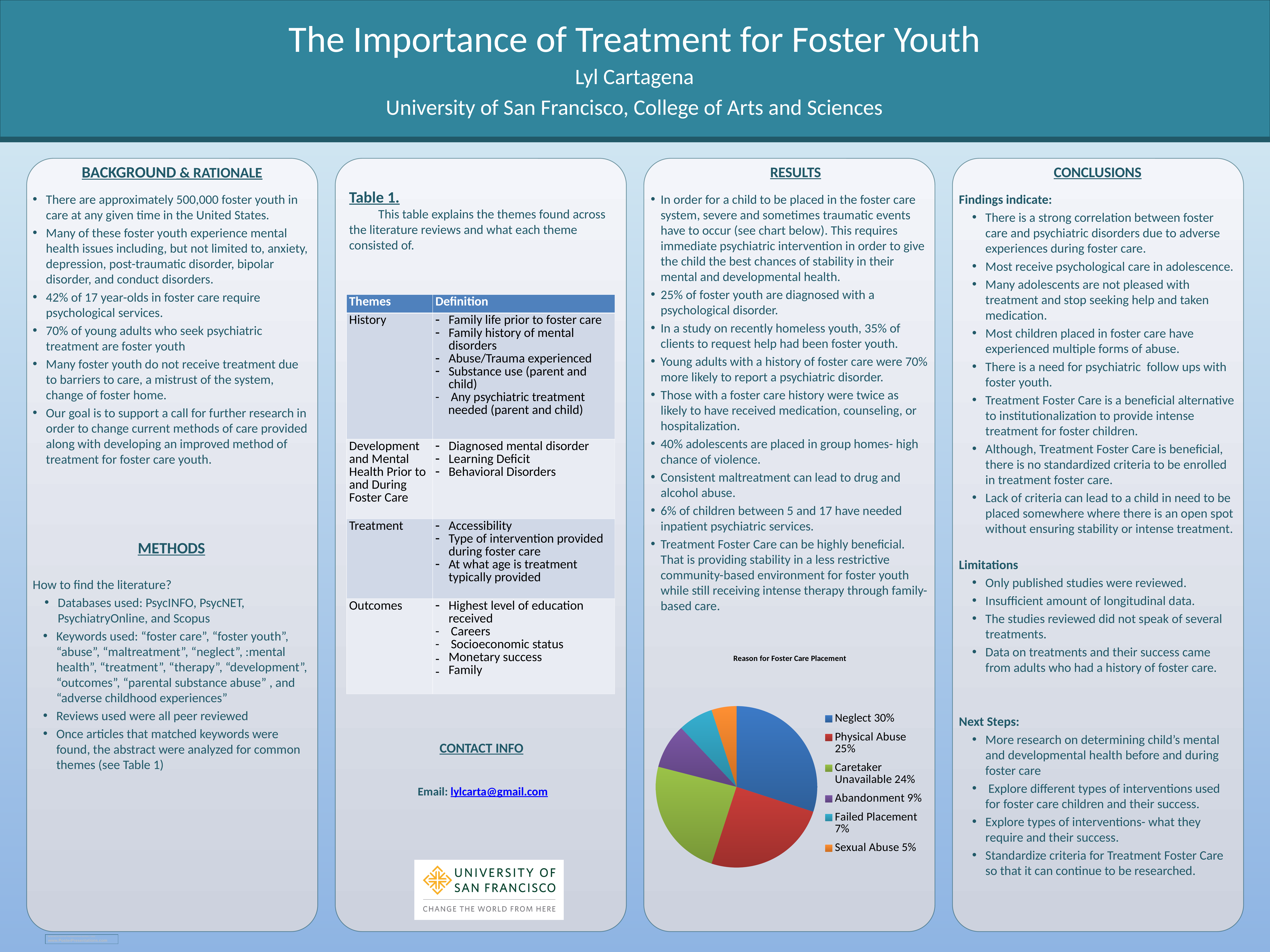
Which is larger in the pie chart, Abandonment or Failed Placement? Abandonment What percentage is shown for Caretaker Unavailable in the pie chart? 24% What type of chart is shown under the title "Reason for Foster Care Placement"? pie chart What percentage is shown for Failed Placement in the pie chart? 7% Which reason for foster care placement has the largest slice of the pie? Neglect What colour is the Sexual Abuse slice in the pie chart? orange How many categories does the pie chart show? 6 What share of the pie does Neglect represent? 30% What is the title of the chart on the slide? Reason for Foster Care Placement Which reason for foster care placement has the smallest slice of the pie? Sexual Abuse What percentage is shown for Physical Abuse in the pie chart? 25% What is the difference in percentage points between Neglect and Abandonment in the pie chart? 21